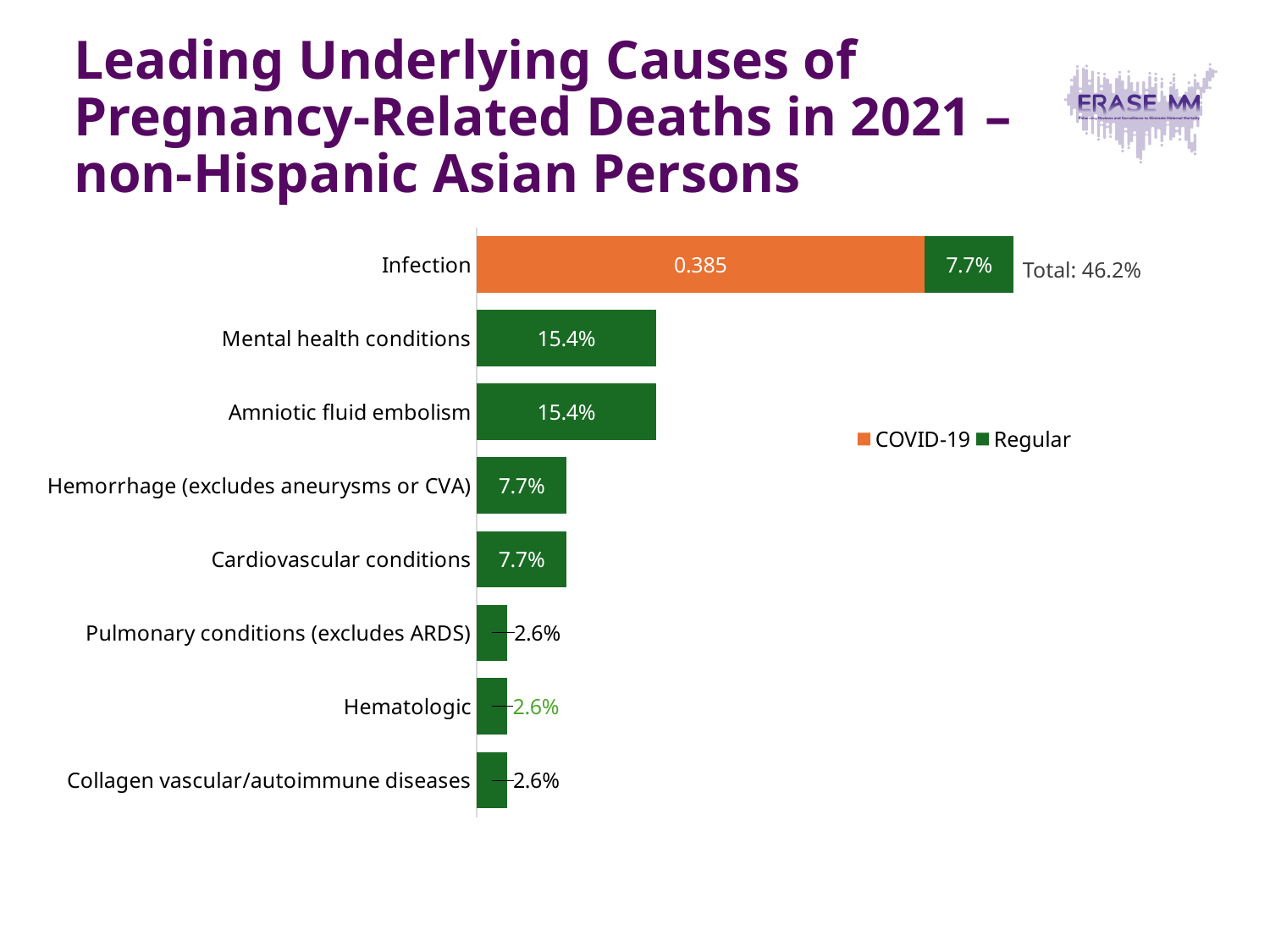
What kind of chart is shown on the slide? Bar chart What is the value for Hematologic? 2.6% What are the two series named in the legend? COVID-19 and Regular What is the Regular value for Mental health conditions? 15.4% What is the COVID-19 value labeled on the Infection bar? 0.385 Which category has the longest bar overall? Infection What total is shown next to the Infection bar? 46.2% How many series does the legend list? 2 How many categories are shown on the chart? 8 Which is larger, the value for Cardiovascular conditions or the value for Pulmonary conditions (excludes ARDS)? Cardiovascular conditions What is the Regular value for Infection? 7.7% What is the difference between the value for Amniotic fluid embolism and the value for Hemorrhage (excludes aneurysms or CVA)? 7.7%